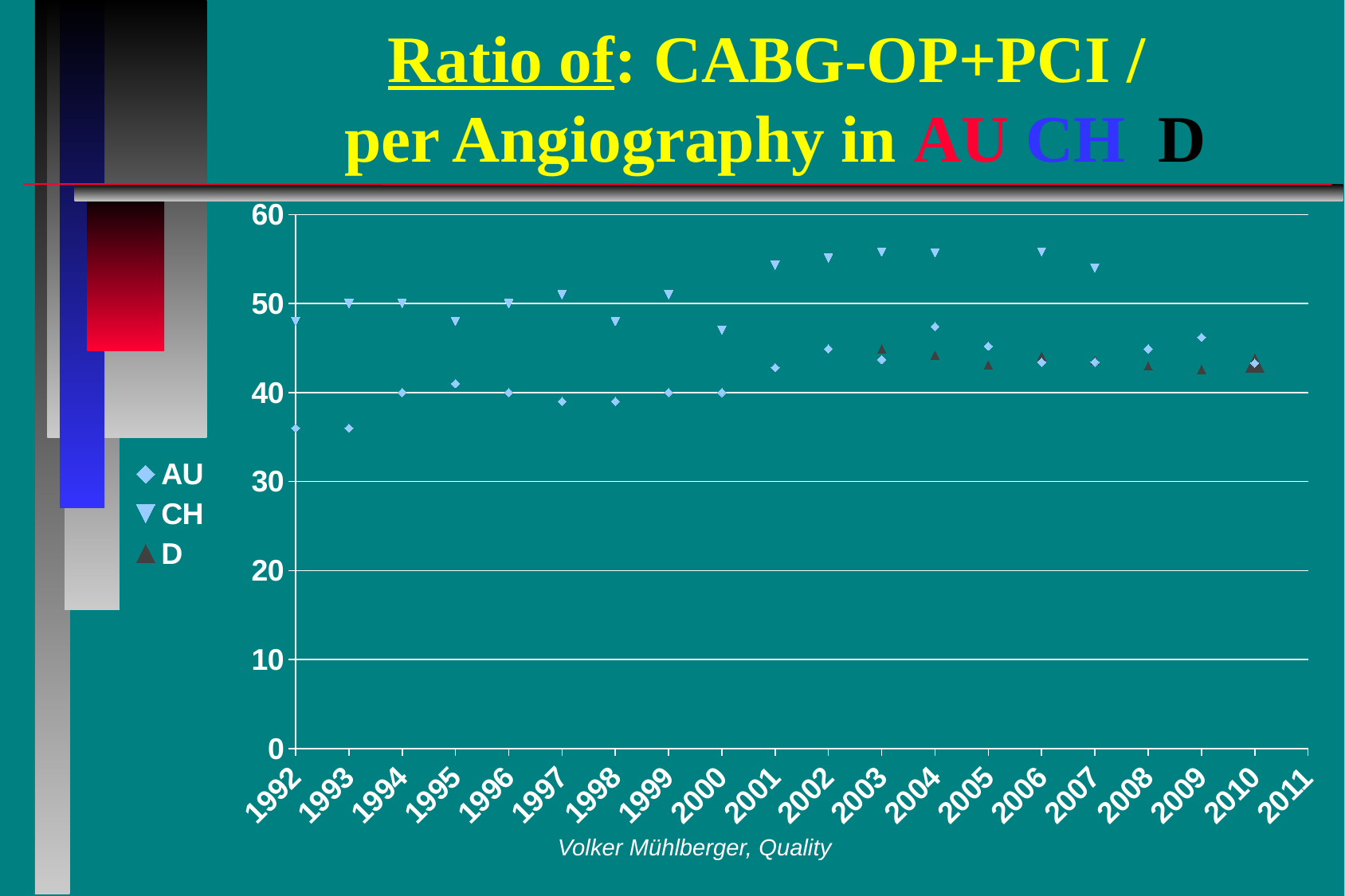
Is the value for CH in 2003 greater or less than 50? greater What kind of chart is shown on the slide? scatter chart Is the value for AU in 1992 greater or less than 40? less In 2002, which series has the larger value, AU or CH? CH Is the value for AU in 2004 greater or less than 40? greater In 2004, which series has the larger value, D or CH? CH Which series has the highest values overall on the chart? CH Do the AU values generally rise or fall from 1992 to 2009? rise How many series does the legend list? 3 What are the three series named in the legend? AU, CH, D